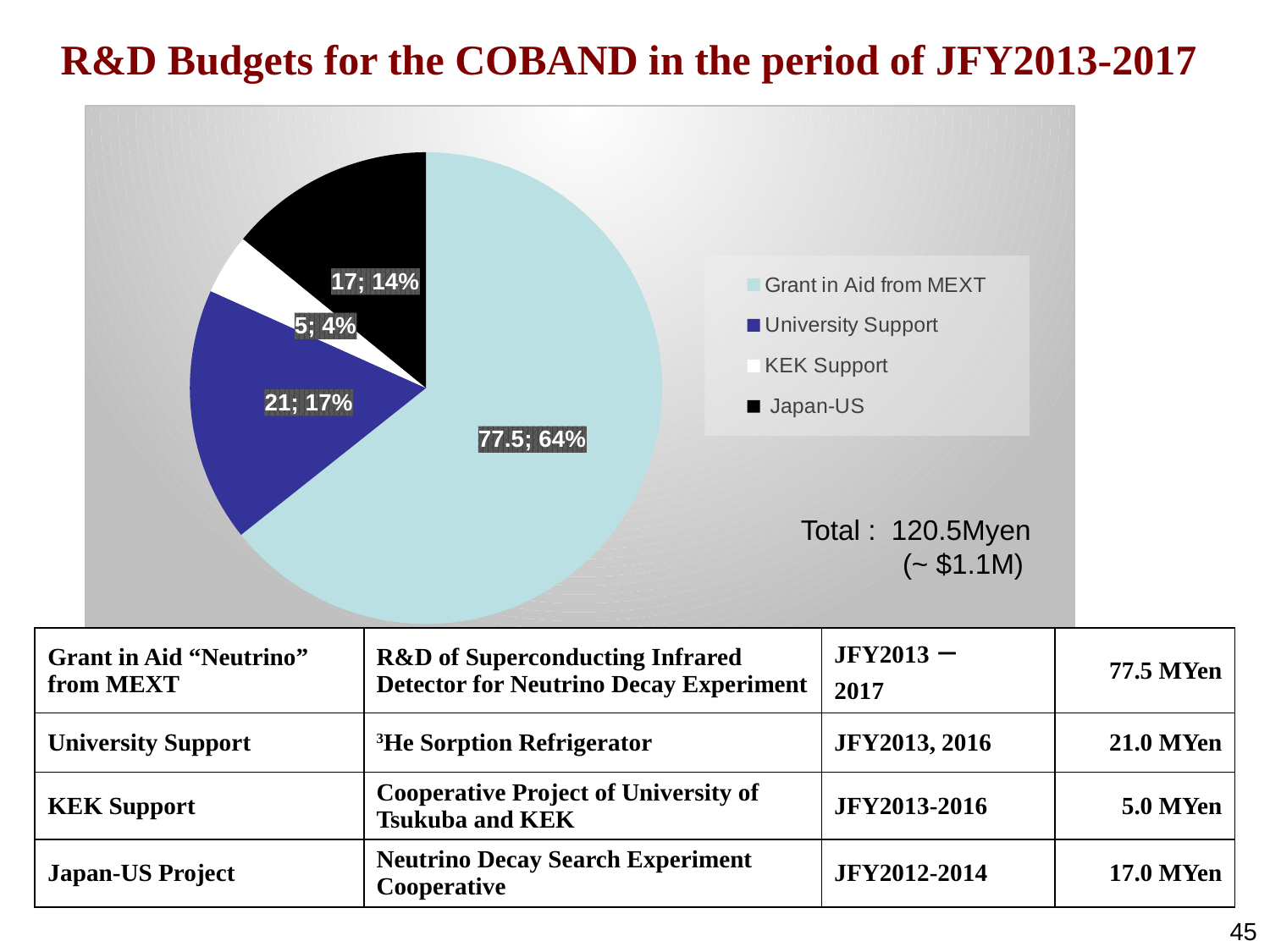
What is the difference between the Grant in Aid from MEXT value and the University Support value? 56.5 What percentage share of the pie does Japan-US have? 14% Which category has the smallest slice of the pie? KEK Support Which category has the largest slice of the pie? Grant in Aid from MEXT What kind of chart is shown on the slide? pie chart What value is shown for the Grant in Aid from MEXT slice? 77.5; 64% What value is shown for the Japan-US slice? 17; 14% Which is larger, the University Support slice or the Japan-US slice? University Support What value is shown for the University Support slice? 21; 17% What value is shown for the KEK Support slice? 5; 4% How many slices does the pie chart have? 4 What colour is the Japan-US slice in the pie chart? black